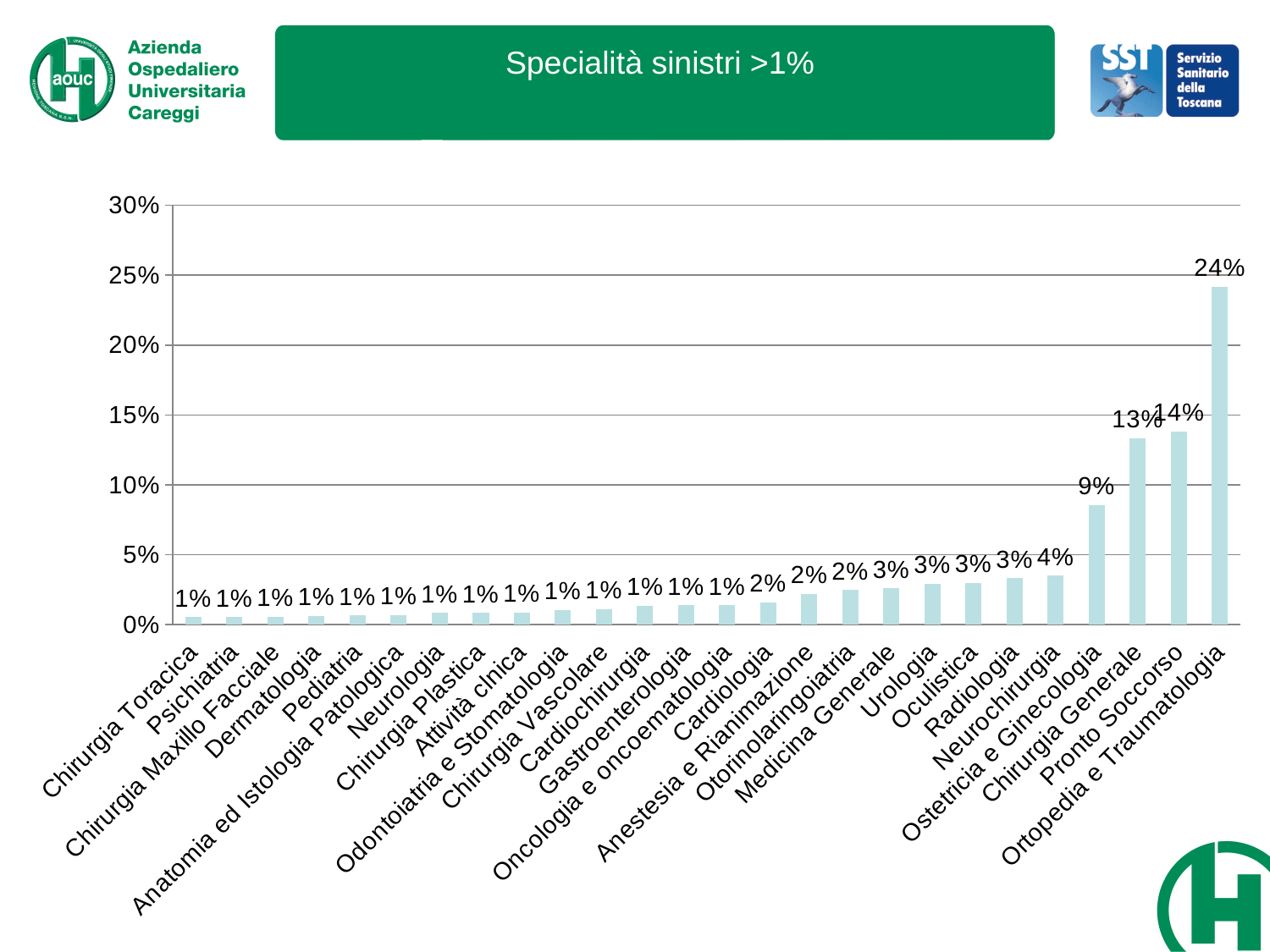
What is the difference between the values for Ortopedia e Traumatologia and Pronto Soccorso? 10% What is the value for Ostetricia e Ginecologia? 9% What is the value for Ortopedia e Traumatologia? 24% Do the values rise or fall from left to right along the x axis? rise What is the title of the slide? Specialità sinistri >1% How many specialties are shown on the x axis? 26 Which specialty has the highest value? Ortopedia e Traumatologia What kind of chart is shown on the slide? bar chart What is the value for Neurochirurgia? 4% What is the value for Pronto Soccorso? 14% Is the value for Ortopedia e Traumatologia greater or less than 20%? greater Which is larger, the value for Chirurgia Generale or the value for Pronto Soccorso? Pronto Soccorso